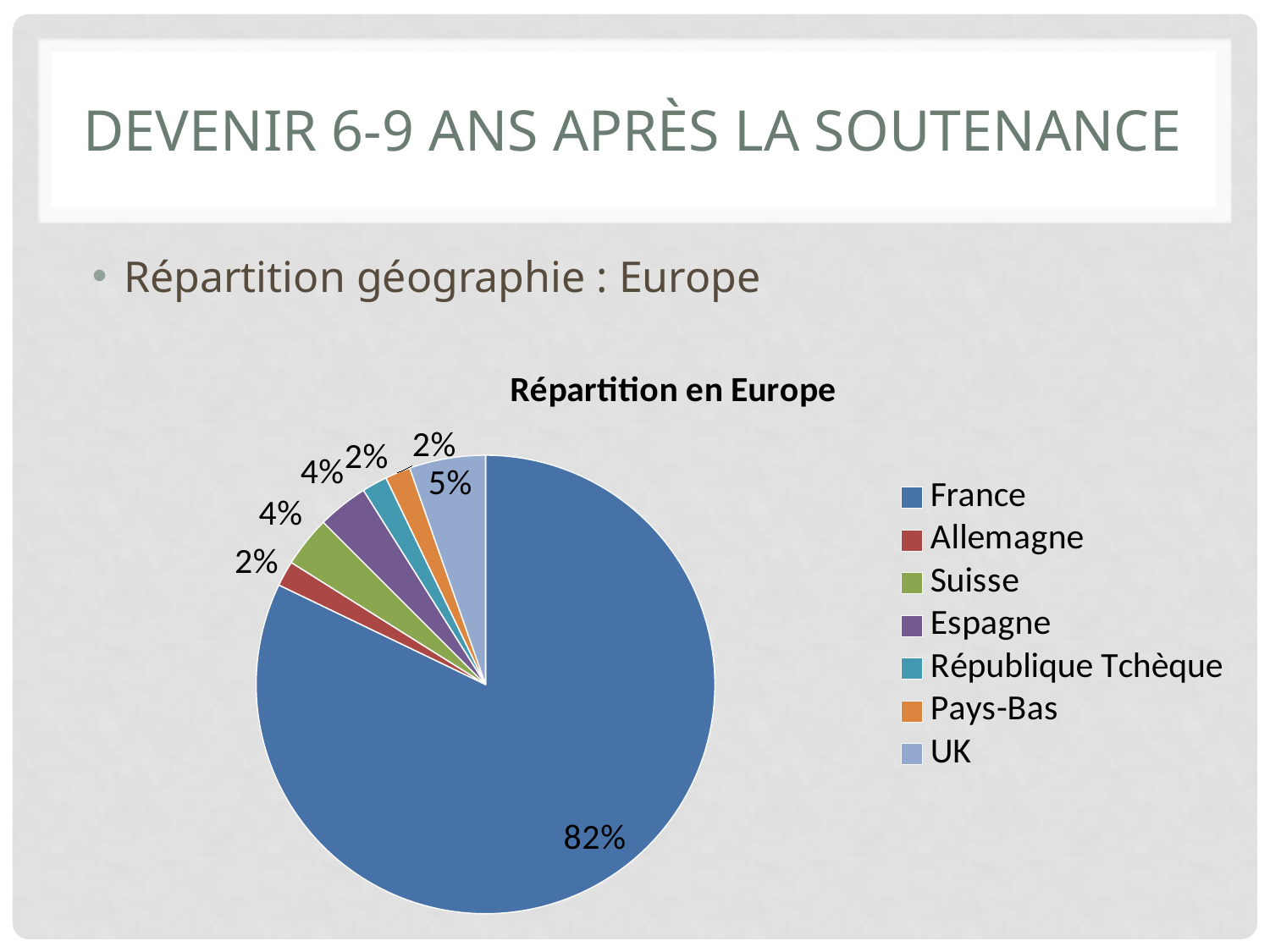
Which is larger, the slice for UK or the slice for Espagne? UK Which category has the largest slice of the pie? France What is the difference in percentage points between the France slice and the UK slice? 77 What is the title of the chart? Répartition en Europe What share of the pie does Suisse represent? 4% How many categories does the legend of the pie chart list? 7 What share of the pie does Pays-Bas represent? 2% Which colour represents France in the pie chart? blue What share of the pie does France represent? 82% What type of chart is shown on the slide? pie chart